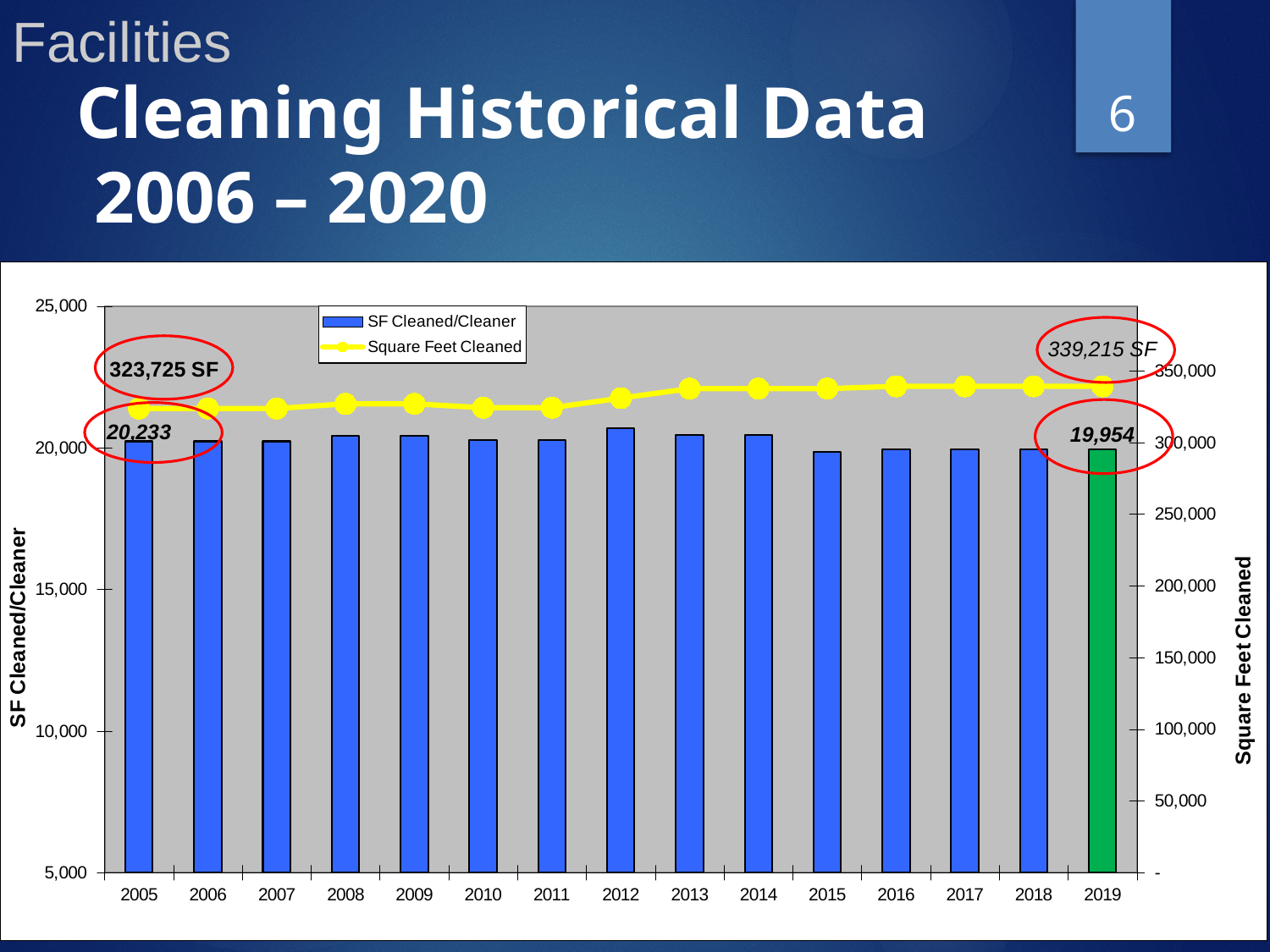
Which year has the higher SF Cleaned/Cleaner value, 2005 or 2019? 2005 How many years are shown on the x axis of the chart? 15 What kind of chart is shown on the slide? A combined bar and line chart By how much did Square Feet Cleaned increase from 2005 to 2019? 15,490 SF What is the Square Feet Cleaned value labelled for 2019? 339,215 SF By how much did SF Cleaned/Cleaner decrease from 2005 to 2019? 279 What is the SF Cleaned/Cleaner value for 2005? 20,233 What is the Square Feet Cleaned value labelled for 2005? 323,725 SF What is the SF Cleaned/Cleaner value for 2019? 19,954 Is the SF Cleaned/Cleaner value for 2012 greater or less than 20,000? greater Which year's bar is coloured green instead of blue? 2019 How many series does the chart legend list? 2